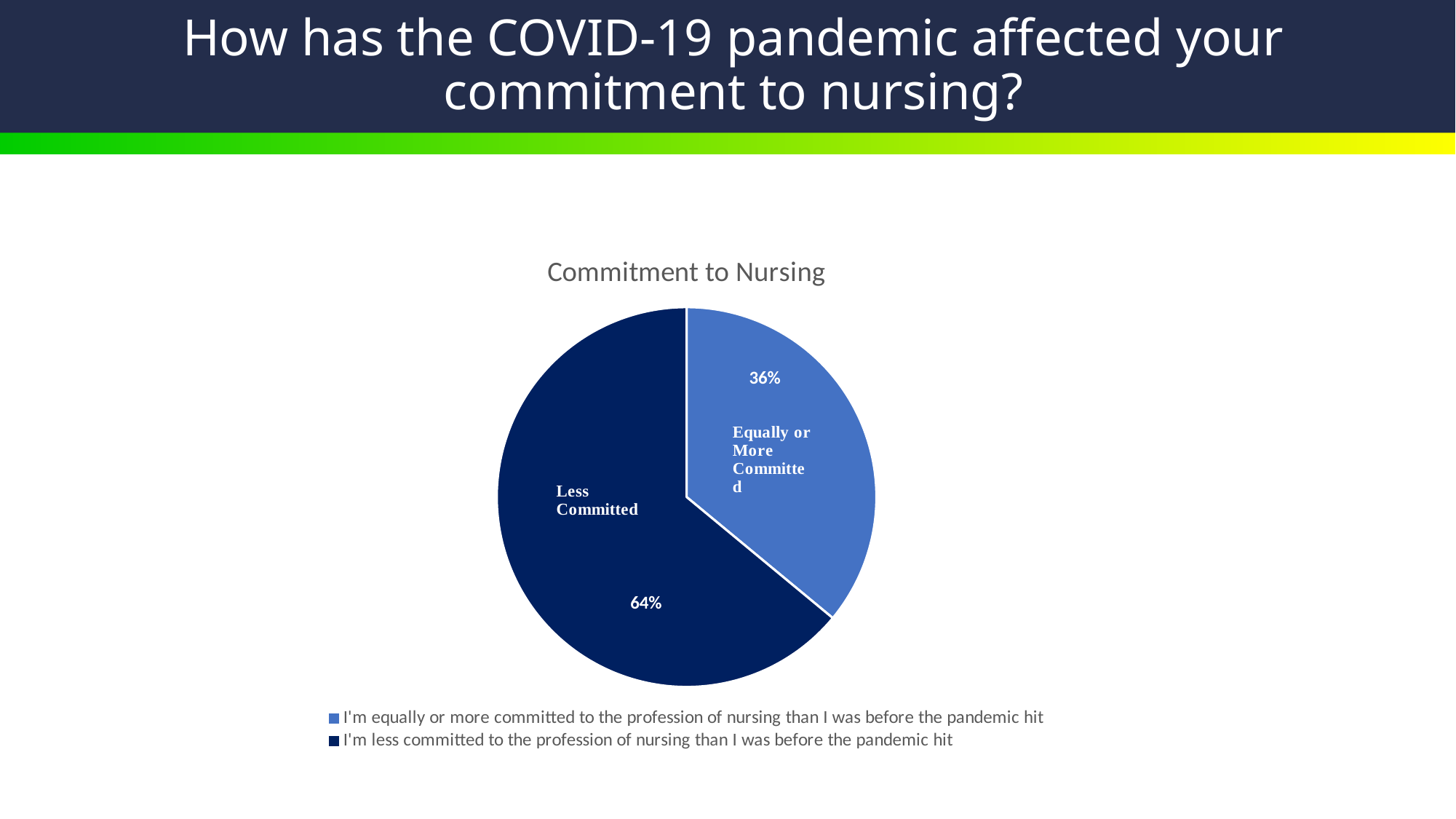
What is the difference in percentage points between the Less Committed and Equally or More Committed slices? 28 How many slices does the pie chart have? 2 How many entries does the legend list? 2 Which is larger: the Less Committed slice or the Equally or More Committed slice? Less Committed What share of the pie does the Less Committed slice represent? 64% What is the title of the chart? Commitment to Nursing Which legend entry is shown in the lighter blue colour? I'm equally or more committed to the profession of nursing than I was before the pandemic hit What percentage of respondents are Less Committed? 64% Which slice of the pie is the largest? Less Committed What percentage of respondents are Equally or More Committed? 36% Which slice of the pie is the smallest? Equally or More Committed What kind of chart is shown on the slide? pie chart